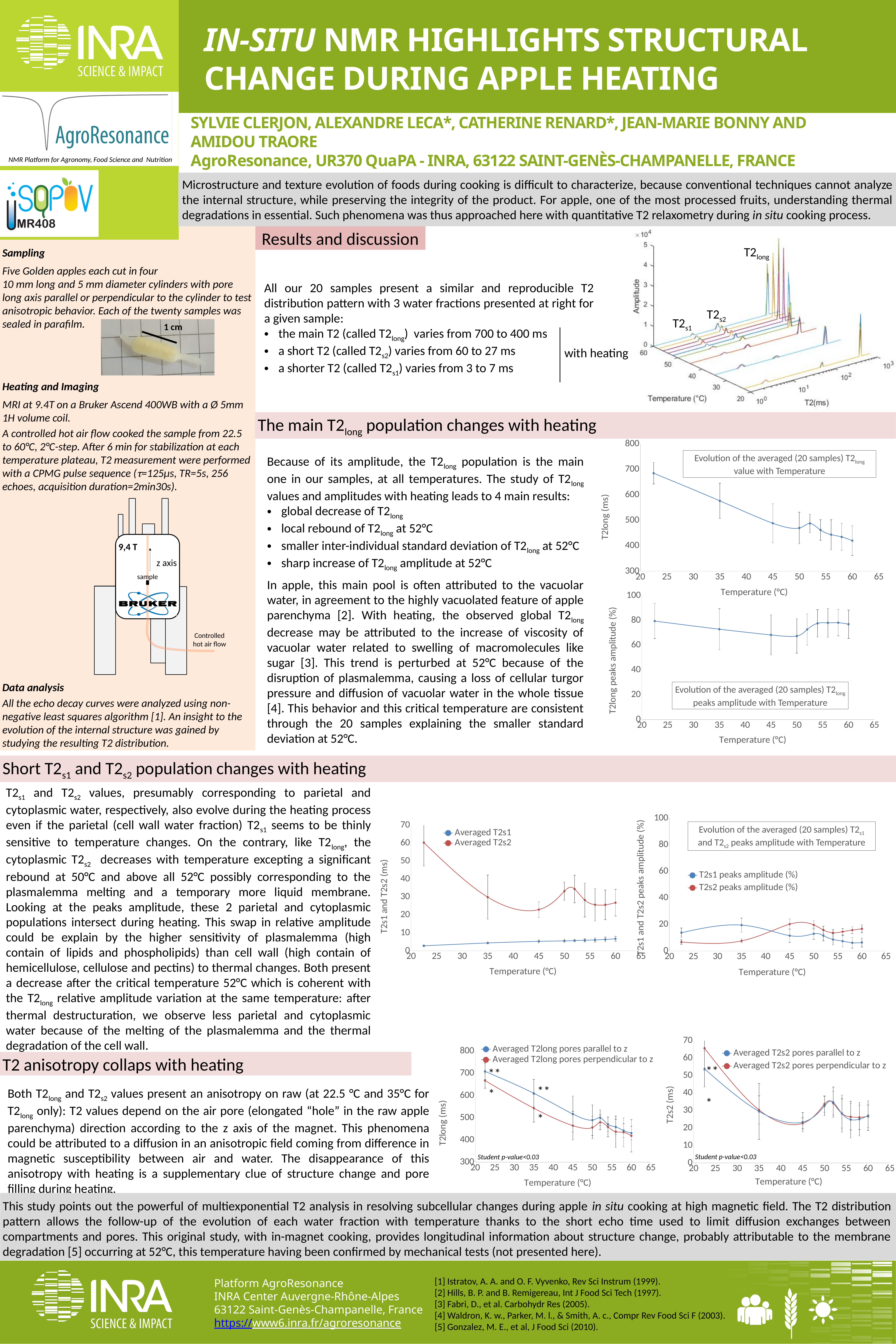
In the chart with the legend 'Averaged T2s2 pores parallel to z' and 'Averaged T2s2 pores perpendicular to z', is the perpendicular-to-z value at the lowest temperature (about 22.5°C) greater or less than 60? greater In the chart titled 'Evolution of the averaged (20 samples) T2long value with Temperature', what kind of chart is it? line chart In the chart titled 'Evolution of the averaged (20 samples) T2s1 and T2s2 peaks amplitude with Temperature', which series has the larger value at 45°C? T2s2 peaks amplitude (%) In the chart titled 'Evolution of the averaged (20 samples) T2long value with Temperature', is the T2long value at 60°C greater or less than 500? less In the chart with the legend 'Averaged T2s1' and 'Averaged T2s2', how many series does the legend list? 2 In the chart with the legend 'Averaged T2s2 pores parallel to z' and 'Averaged T2s2 pores perpendicular to z', what is the label of the x axis? Temperature (°C) In the chart titled 'Evolution of the averaged (20 samples) T2long value with Temperature', is the T2long value at the lowest temperature (about 22.5°C) greater or less than 600? greater In the chart with the legend 'Averaged T2long pores parallel to z' and 'Averaged T2long pores perpendicular to z', which series has the larger value at the lowest temperature (about 22.5°C)? Averaged T2long pores parallel to z In the chart titled 'Evolution of the averaged (20 samples) T2long value with Temperature', do the values generally rise or fall as temperature increases? fall In the chart with the legend 'Averaged T2s1' and 'Averaged T2s2', which series has the larger value at 60°C? Averaged T2s2